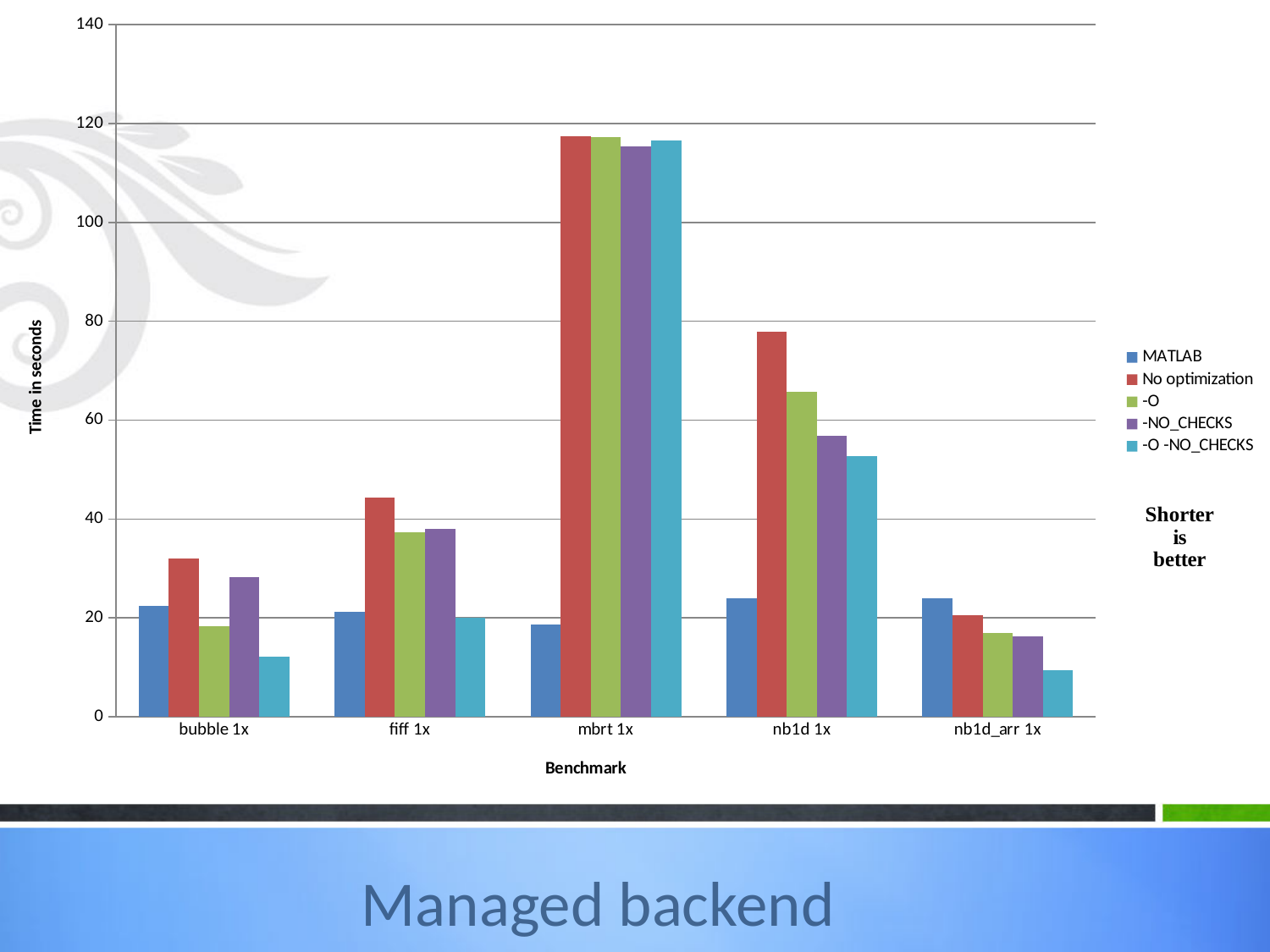
For bubble 1x, which is larger: the -NO_CHECKS value or the -O value? -NO_CHECKS What kind of chart is shown on the slide? bar chart Is the -O -NO_CHECKS value for bubble 1x greater or less than 20? less What is the label of the y axis? Time in seconds Is the No optimization value for mbrt 1x greater or less than 100? greater Which benchmark has the lowest -O -NO_CHECKS bar? nb1d_arr 1x How many series does the legend list? 5 Is the No optimization value for nb1d 1x greater or less than 60? greater Which benchmark has the highest No optimization bar? mbrt 1x How many benchmarks are shown on the x axis? 5 For nb1d 1x, which is larger: the No optimization value or the MATLAB value? No optimization